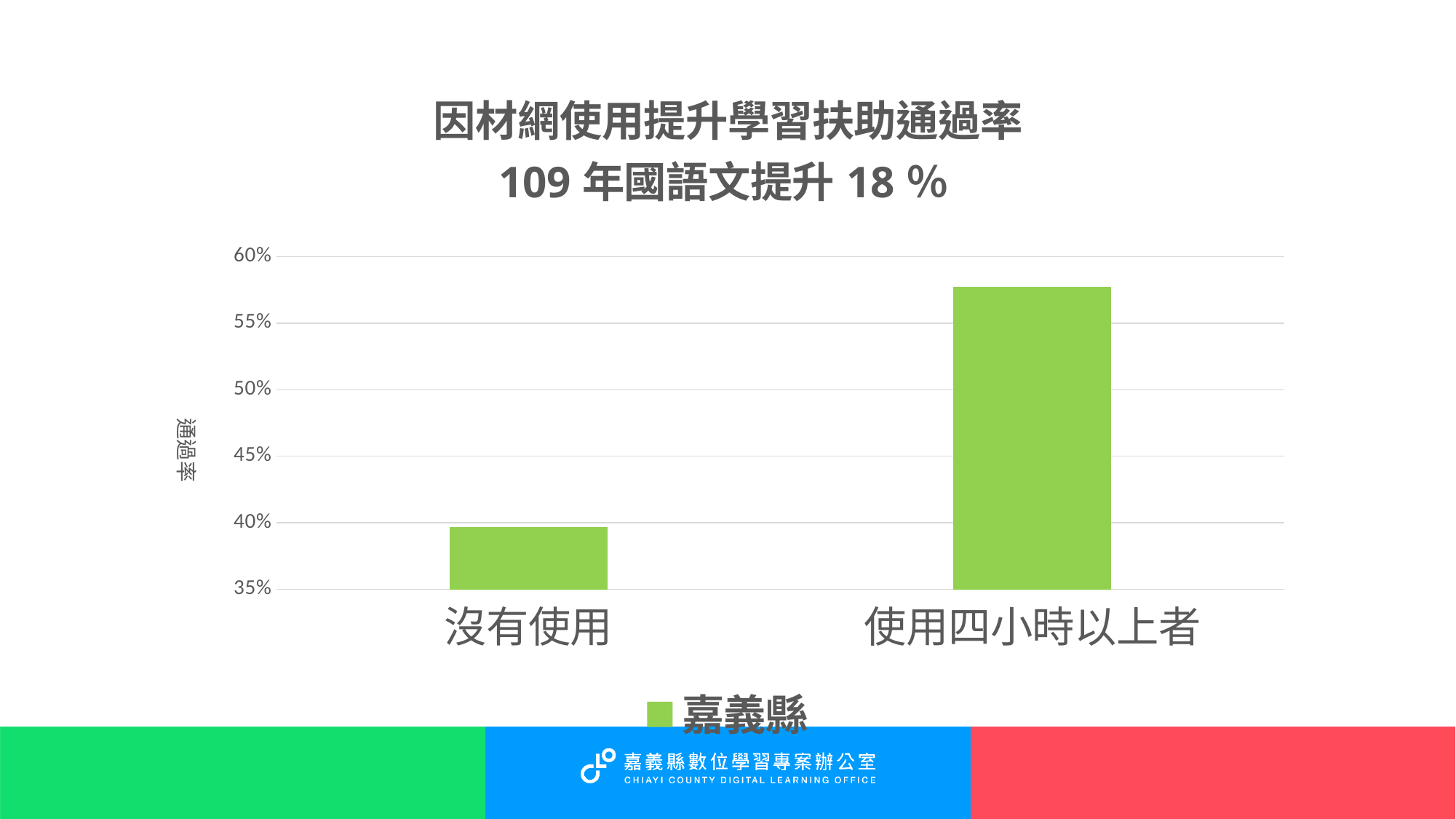
What is the label of the vertical axis? 通過率 Which category has the highest pass rate (通過率)? 使用四小時以上者 Which category has the lowest pass rate (通過率)? 沒有使用 Do the values rise or fall from left to right along the x axis? rise What kind of chart is shown on the slide? bar chart How many series does the legend list? 1 Is the value for 使用四小時以上者 greater or less than 55%? greater What series name is shown in the legend? 嘉義縣 Which is larger, the value for 沒有使用 or the value for 使用四小時以上者? 使用四小時以上者 How many categories are plotted on the x axis? 2 Is the value for 使用四小時以上者 greater or less than 60%? less